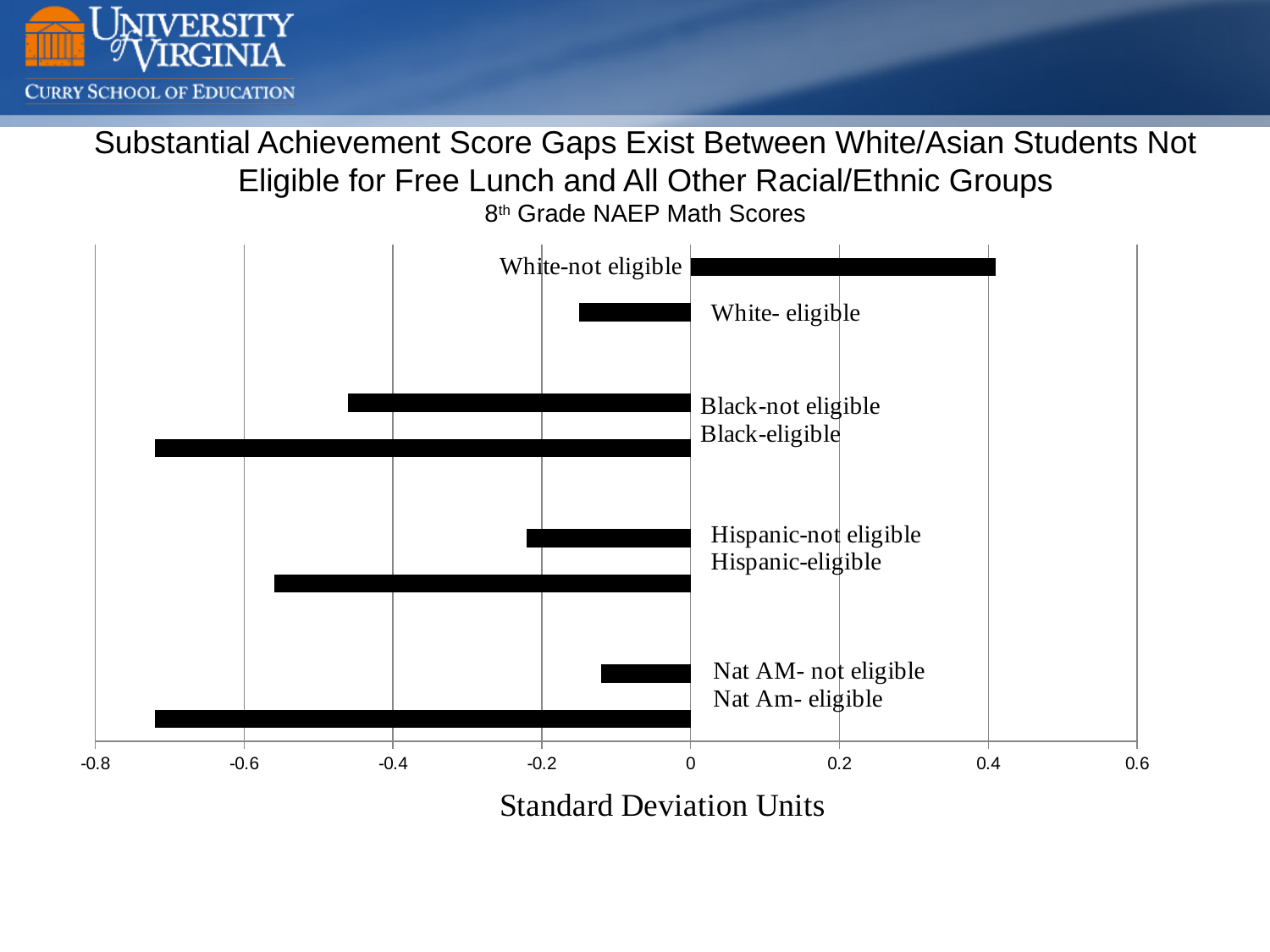
Is the value for Black-not eligible greater or less than -0.4? less Which category is the only one with a positive value? White-not eligible Which has the larger value, Black-not eligible or Black-eligible? Black-not eligible Is the value for Hispanic-eligible greater or less than -0.4? less Is the value for White- eligible greater or less than -0.2? greater Which has the larger value, Hispanic-not eligible or Hispanic-eligible? Hispanic-not eligible Which category has the highest value in the chart? White-not eligible How many bars (categories) are plotted in the chart? 8 What kind of chart is shown on the slide? bar chart What is the title of the horizontal axis of the chart? Standard Deviation Units